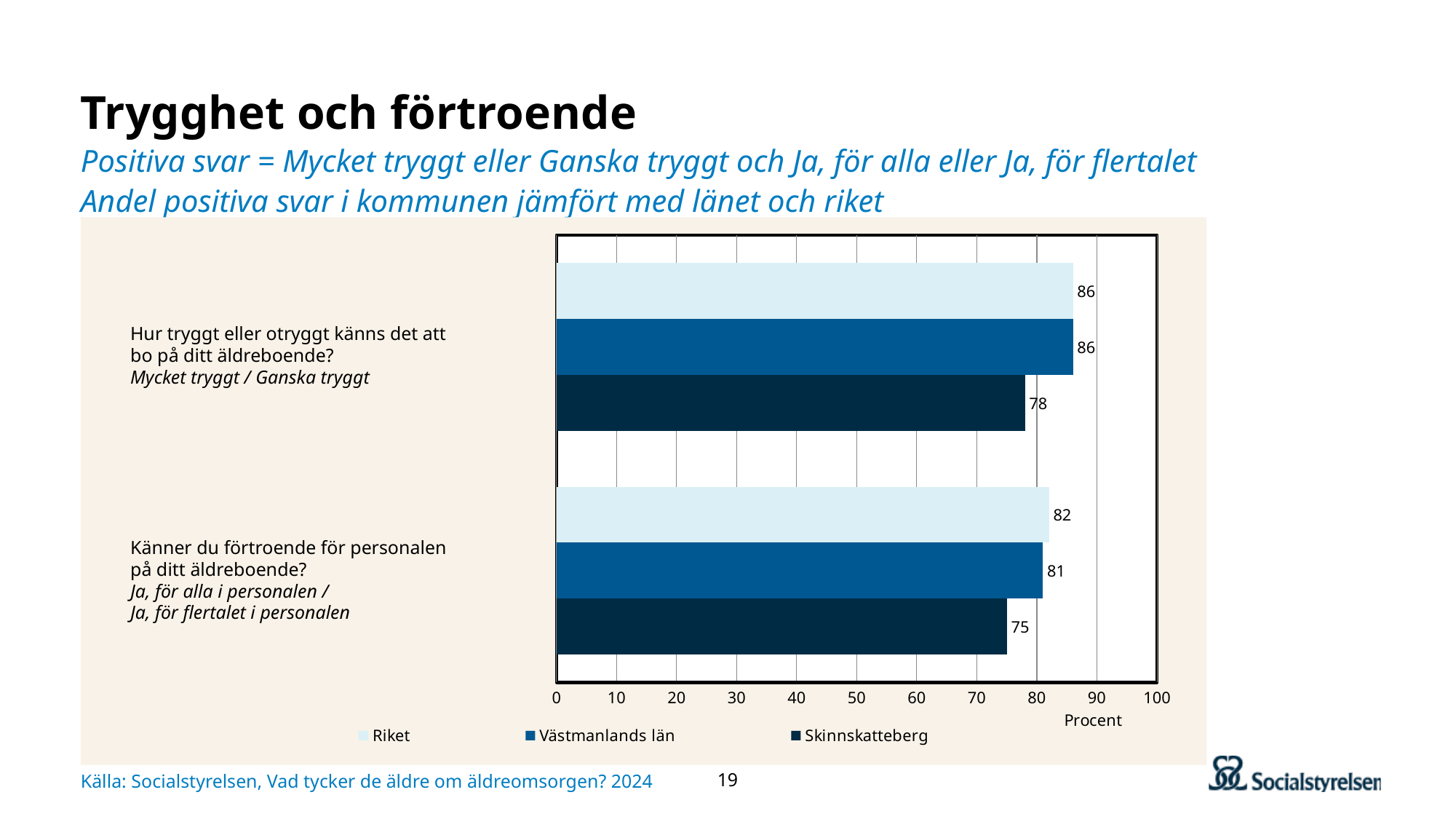
Which is larger for Skinnskatteberg: the value for the trygghet question or the value for the förtroende question? The trygghet question (78) What unit is shown on the x axis of the chart? Procent What is the difference between Riket and Skinnskatteberg on the question "Hur tryggt eller otryggt känns det att bo på ditt äldreboende?"? 8 What is the difference between Västmanlands län and Skinnskatteberg on the question "Känner du förtroende för personalen på ditt äldreboende?"? 6 What is the value for Riket on the question "Känner du förtroende för personalen på ditt äldreboende?"? 82 Which series has the lowest value on the question "Hur tryggt eller otryggt känns det att bo på ditt äldreboende?"? Skinnskatteberg What is the value for Västmanlands län on the question "Känner du förtroende för personalen på ditt äldreboende?"? 81 What is the value for Skinnskatteberg on the question "Hur tryggt eller otryggt känns det att bo på ditt äldreboende?"? 78 What is the value for Skinnskatteberg on the question "Känner du förtroende för personalen på ditt äldreboende?"? 75 How many questions (categories) are shown on the chart? 2 What kind of chart is shown on the slide? Bar chart How many series does the legend list? 3